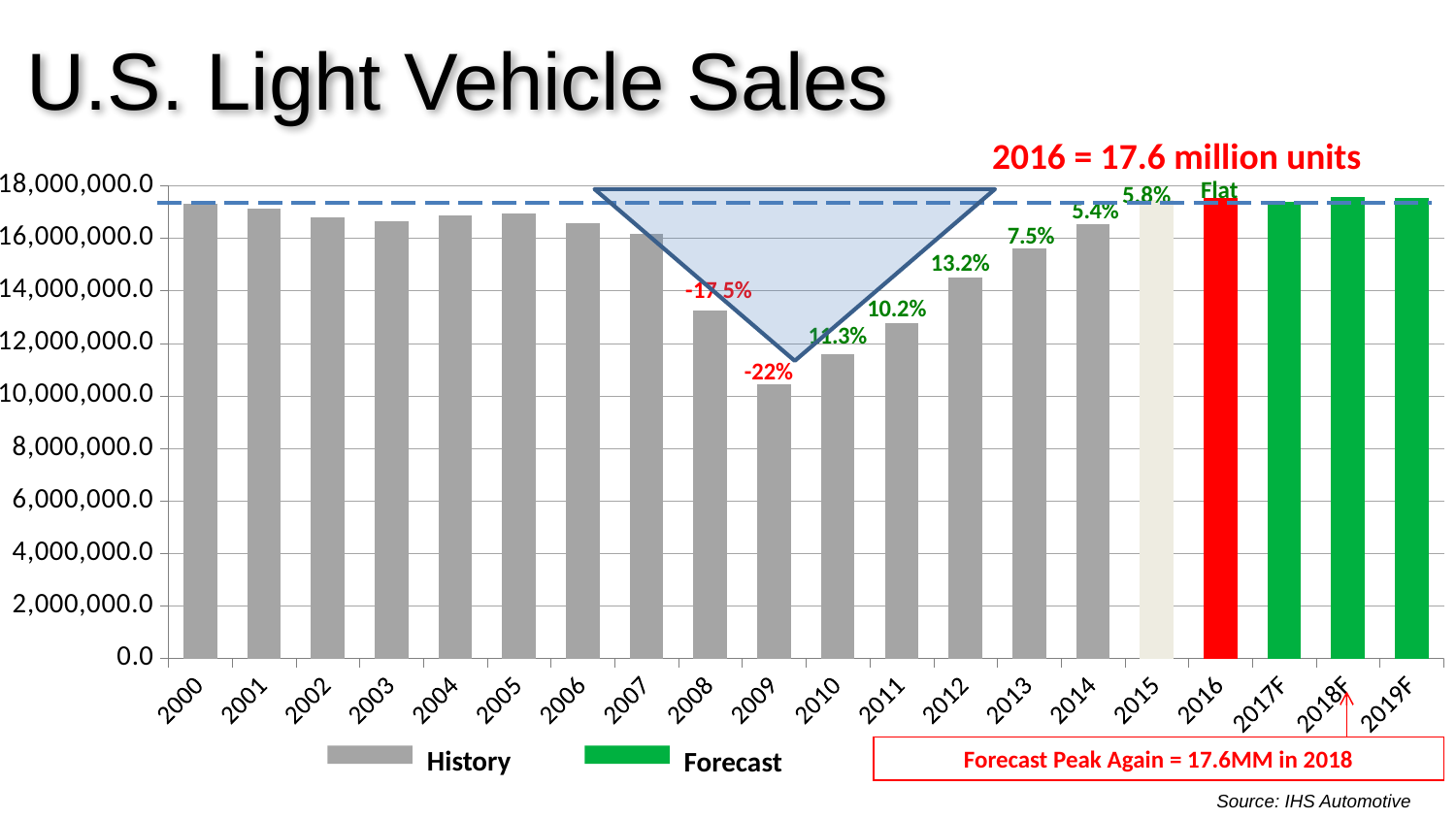
Is the value for 2009 greater or less than 12,000,000? less Which year has higher sales, 2009 or 2010? 2010 What percentage change is labelled above the 2012 bar? 13.2% According to the annotation on the chart, how many units were sold in 2016? 17.6 million units How many series does the chart legend list? 2 Is the value for 2000 greater or less than 16,000,000? greater Do the sales values rise or fall from 2009 to 2016? rise What kind of chart is shown on the slide? bar chart Which year has the lowest U.S. light vehicle sales in the chart? 2009 What percentage change is labelled above the 2014 bar? 5.4% What percentage change is labelled above the 2009 bar? -22% How many years (categories) are shown on the x axis of the chart? 20